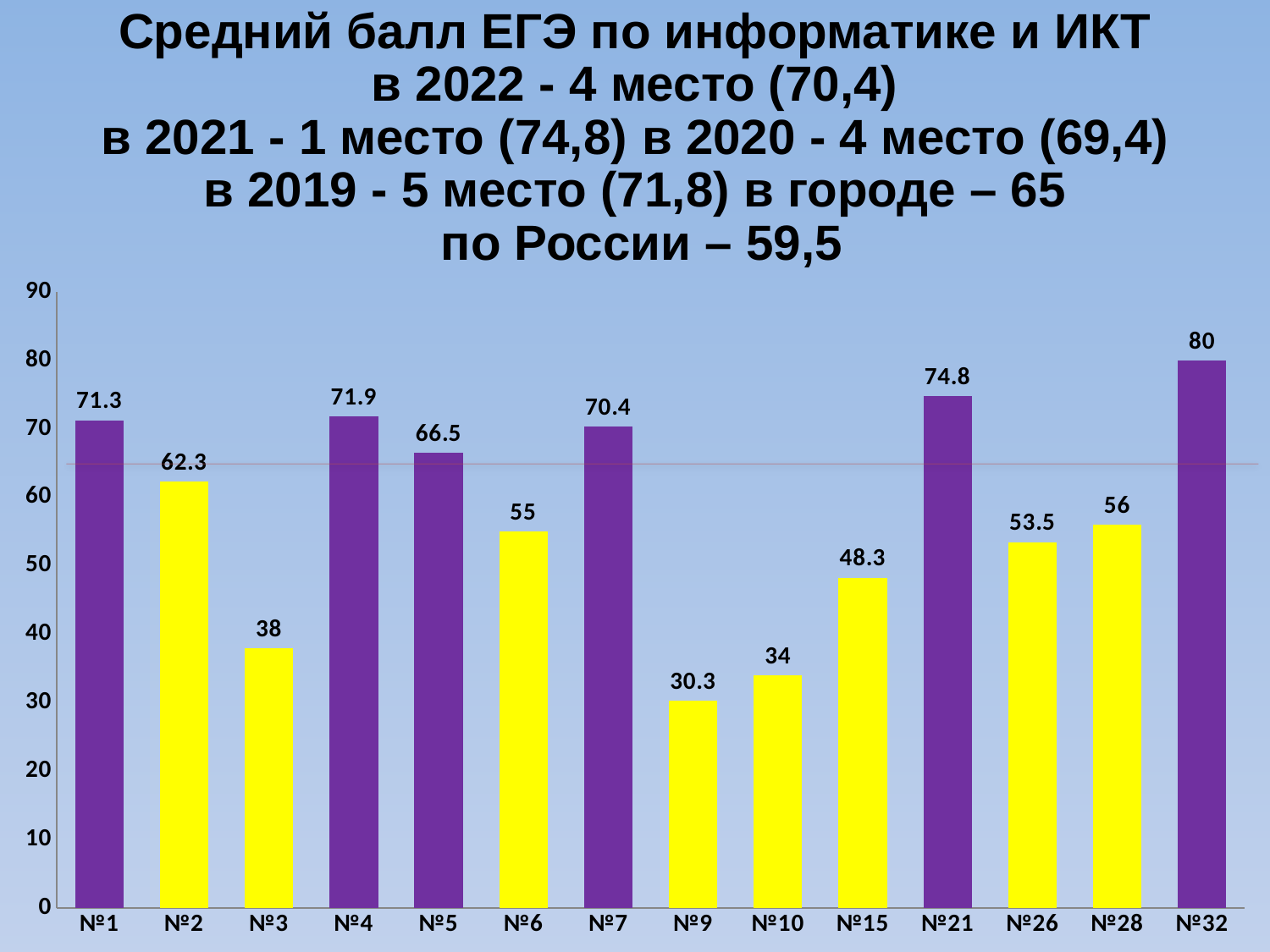
How many categories are shown on the x axis? 14 What is the difference between the values for №32 and №9? 49.7 What is the difference between the values for №4 and №1? 0.6 What colour are the bars for №1, №4, №5, №7, №21 and №32? purple Which is larger, the value for №2 or the value for №28? №2 What is the value for №21? 74.8 Which category has the highest value? №32 What is the value for №9? 30.3 Is the value for №26 greater or less than 50? greater What kind of chart is shown on the slide? bar chart What is the value for №15? 48.3 Which category has the lowest value? №9